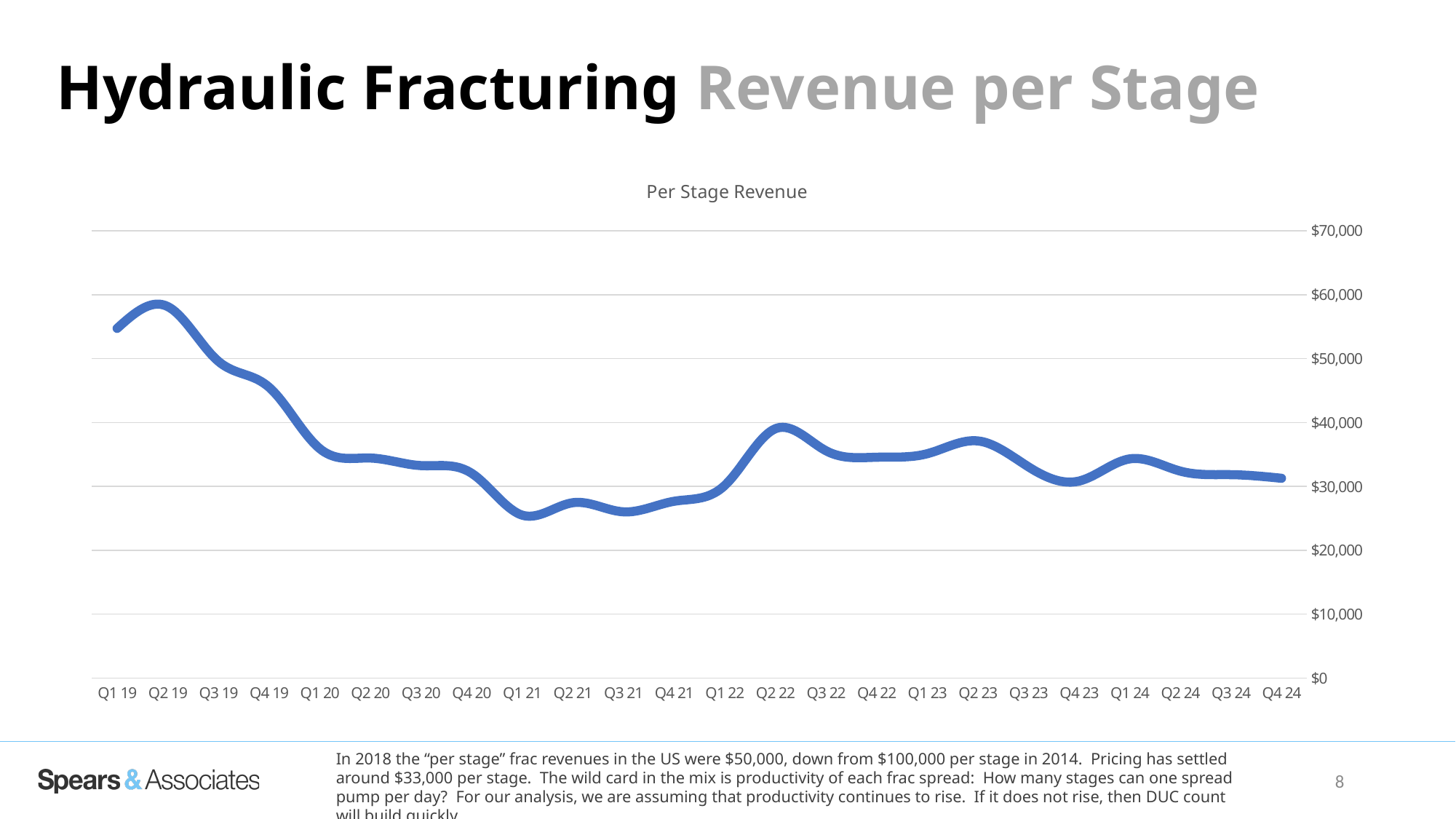
Does per stage revenue overall rise or fall from Q1 19 to Q4 24? fall What is the title of the chart? Per Stage Revenue Which has the higher per stage revenue, Q2 22 or Q3 21? Q2 22 Is the per stage revenue for Q1 19 greater or less than $50,000? greater Is the per stage revenue for Q1 20 greater or less than $40,000? less Is the per stage revenue for Q2 19 greater or less than $50,000? greater Which has the higher per stage revenue, Q2 19 or Q4 24? Q2 19 What kind of chart is shown on the slide? Line chart Which quarter has the highest per stage revenue? Q2 19 How many quarters are plotted along the x axis of the Per Stage Revenue chart? 24